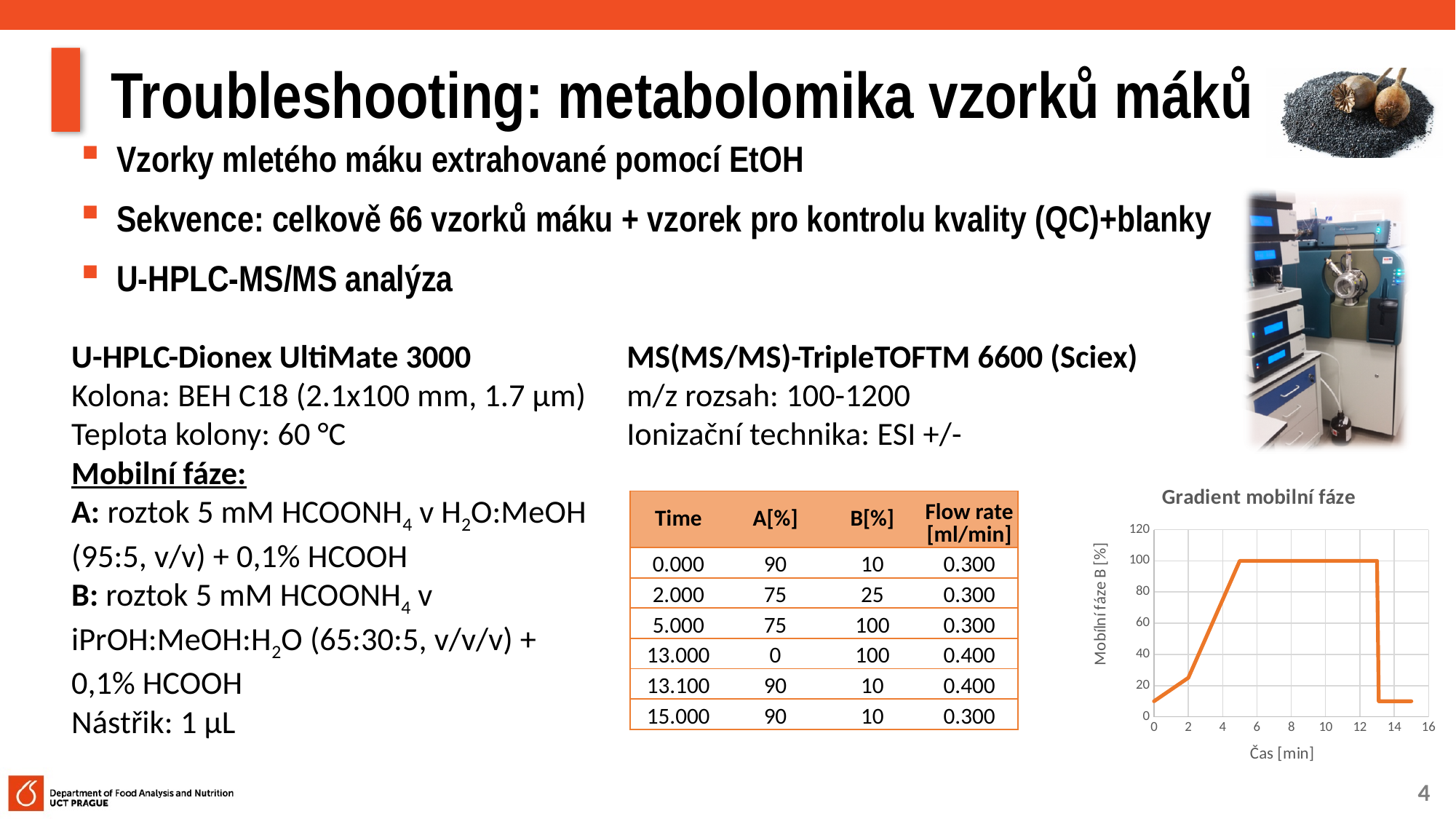
What is the label of the x axis of the chart? Čas [min] What is the highest value of Mobilní fáze B [%] reached on the chart? 100 Does the value of Mobilní fáze B [%] rise or fall between 0 and 5 min on the chart? rise Is the value of Mobilní fáze B [%] at 0 min greater or less than 20? less Is the value of Mobilní fáze B [%] at 4 min greater or less than 60? greater Does the value of Mobilní fáze B [%] rise or fall between 12 and 14 min on the chart? fall What kind of chart is shown on the slide? line chart What is the value of Mobilní fáze B [%] at 10 min on the chart? 100 Which is larger on the chart: the value of Mobilní fáze B [%] at 6 min or at 14 min? 6 min What is the title of the chart on the slide? Gradient mobilní fáze What is the value of Mobilní fáze B [%] at 8 min on the chart? 100 Is the value of Mobilní fáze B [%] at 14 min greater or less than 20? less